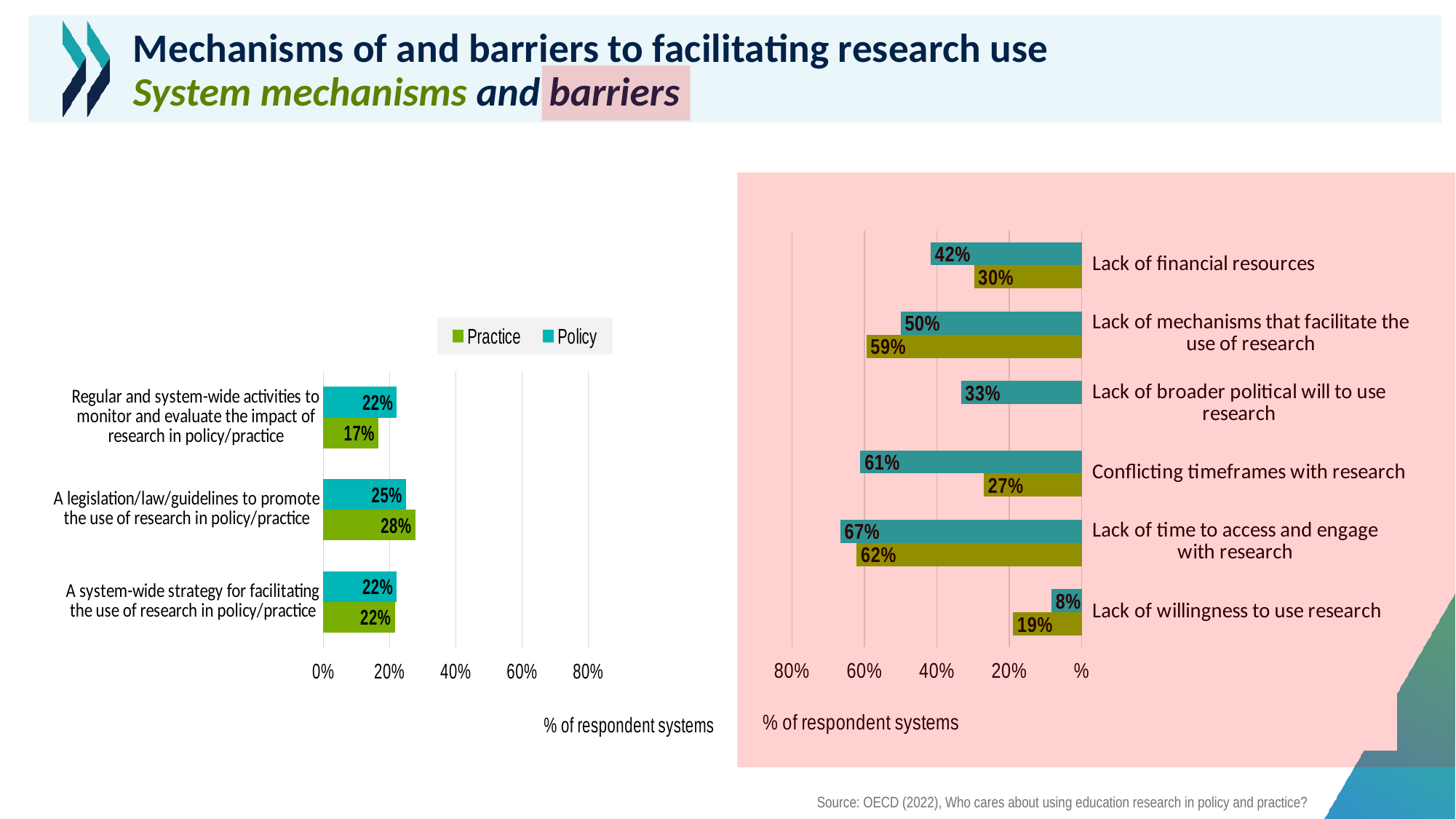
On the right chart, which category has the lowest teal bar value? Lack of willingness to use research On the left chart, what is the Policy value for 'A legislation/law/guidelines to promote the use of research in policy/practice'? 25% On the left chart, what is the Practice value for 'Regular and system-wide activities to monitor and evaluate the impact of research in policy/practice'? 17% On the right chart, what is the value of the upper (teal) bar for 'Lack of time to access and engage with research'? 67% On the left chart, what is the difference between the Practice and Policy values for 'A legislation/law/guidelines to promote the use of research in policy/practice'? 3% On the right chart, which is larger for 'Lack of financial resources': the teal bar or the olive bar? The teal bar (42%) On the right chart, what is the value of the lower (olive) bar for 'Lack of mechanisms that facilitate the use of research'? 59% On the left chart, which category has the highest Practice value? A legislation/law/guidelines to promote the use of research in policy/practice On the right chart, how many barrier categories are listed? 6 On the right chart, what is the difference between the teal and olive bars for 'Conflicting timeframes with research'? 34% On the left chart, how many series does the legend list? 2 On the left chart, what kind of chart is shown? Bar chart